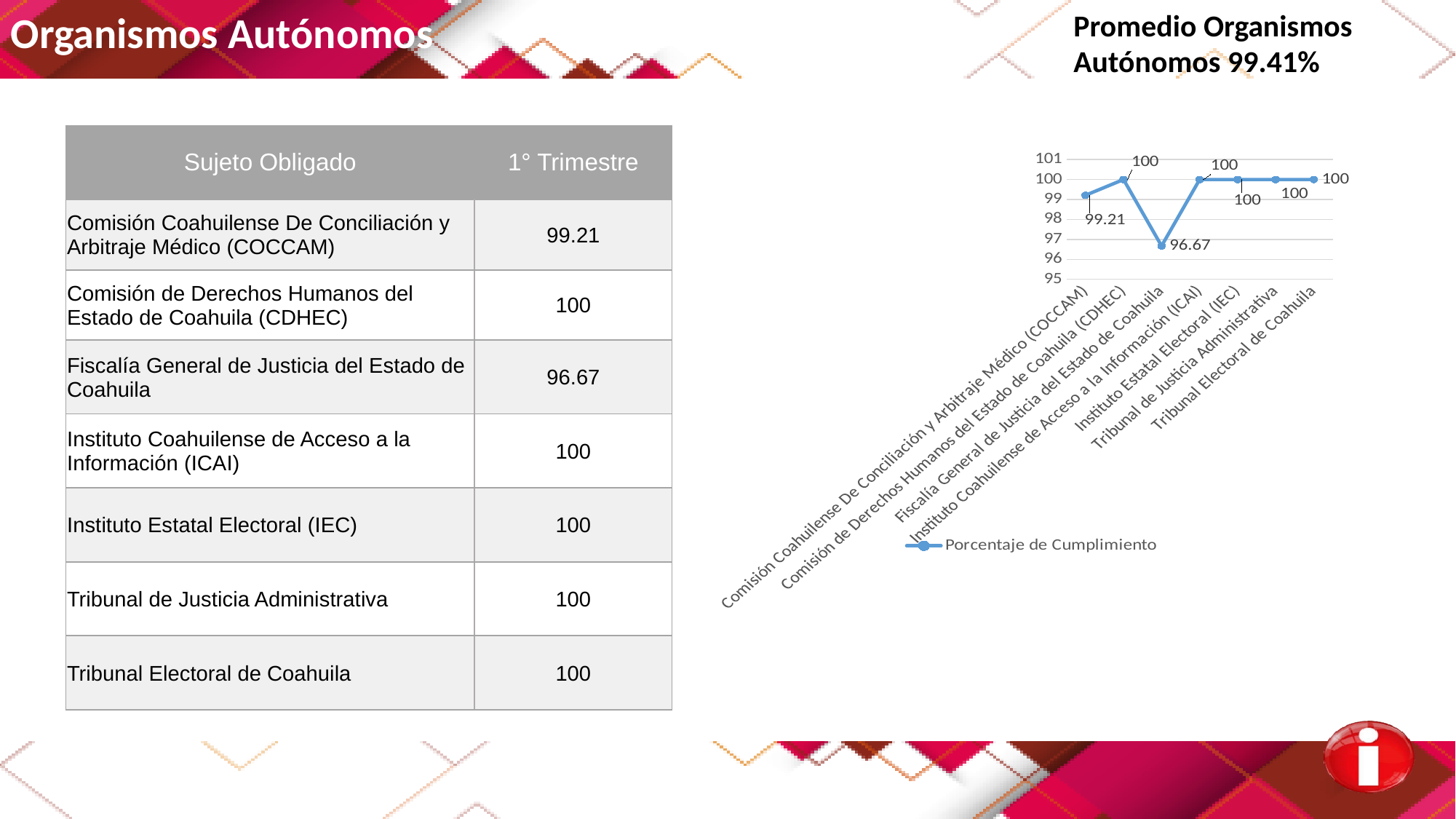
How many categories in the chart have a value of 100? 5 What is the value for Fiscalía General de Justicia del Estado de Coahuila in the chart? 96.67 How many categories are plotted in the chart? 7 How many series does the chart legend list? 1 Is the value for Fiscalía General de Justicia del Estado de Coahuila greater or less than 98? less What type of chart is shown on the slide? line chart Which category has the lowest value in the chart? Fiscalía General de Justicia del Estado de Coahuila What is the difference between the values for Comisión Coahuilense De Conciliación y Arbitraje Médico (COCCAM) and Fiscalía General de Justicia del Estado de Coahuila? 2.54 What is the value for Comisión Coahuilense De Conciliación y Arbitraje Médico (COCCAM) in the chart? 99.21 Which is larger: the value for Comisión de Derechos Humanos del Estado de Coahuila (CDHEC) or the value for Comisión Coahuilense De Conciliación y Arbitraje Médico (COCCAM)? Comisión de Derechos Humanos del Estado de Coahuila (CDHEC) What is the name of the series shown in the chart legend? Porcentaje de Cumplimiento What is the value for Instituto Estatal Electoral (IEC) in the chart? 100